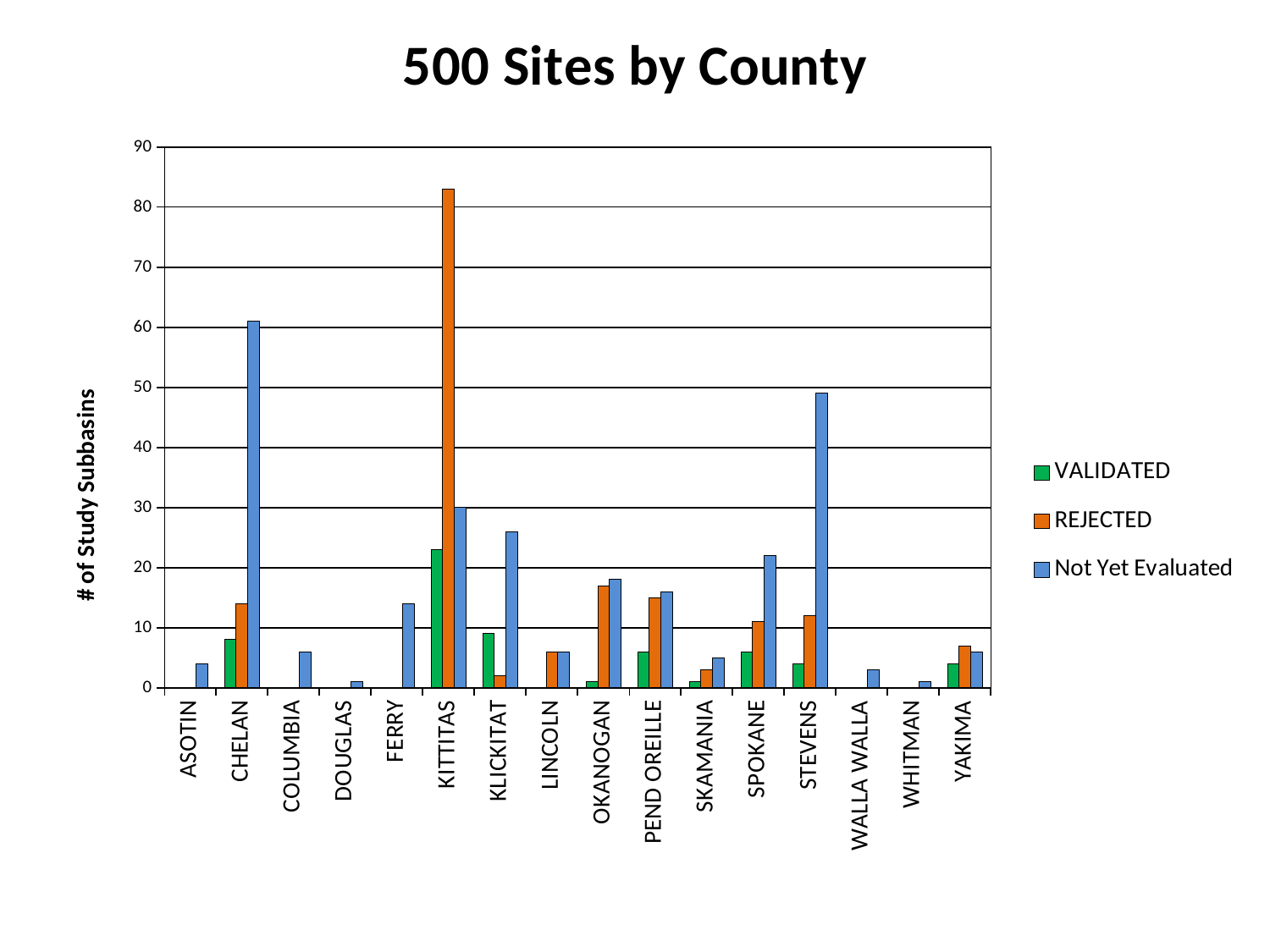
Which county has the highest VALIDATED value? KITTITAS How many series does the legend list? 3 How many counties are shown on the x axis? 16 Is the REJECTED value for KITTITAS greater or less than 80? greater Which is larger, the Not Yet Evaluated value for CHELAN or for STEVENS? CHELAN Which county has the highest REJECTED value? KITTITAS What is the title of the chart? 500 Sites by County What type of chart is shown on the slide? Bar chart Which county has the highest Not Yet Evaluated value? CHELAN What is the label on the vertical axis? # of Study Subbasins